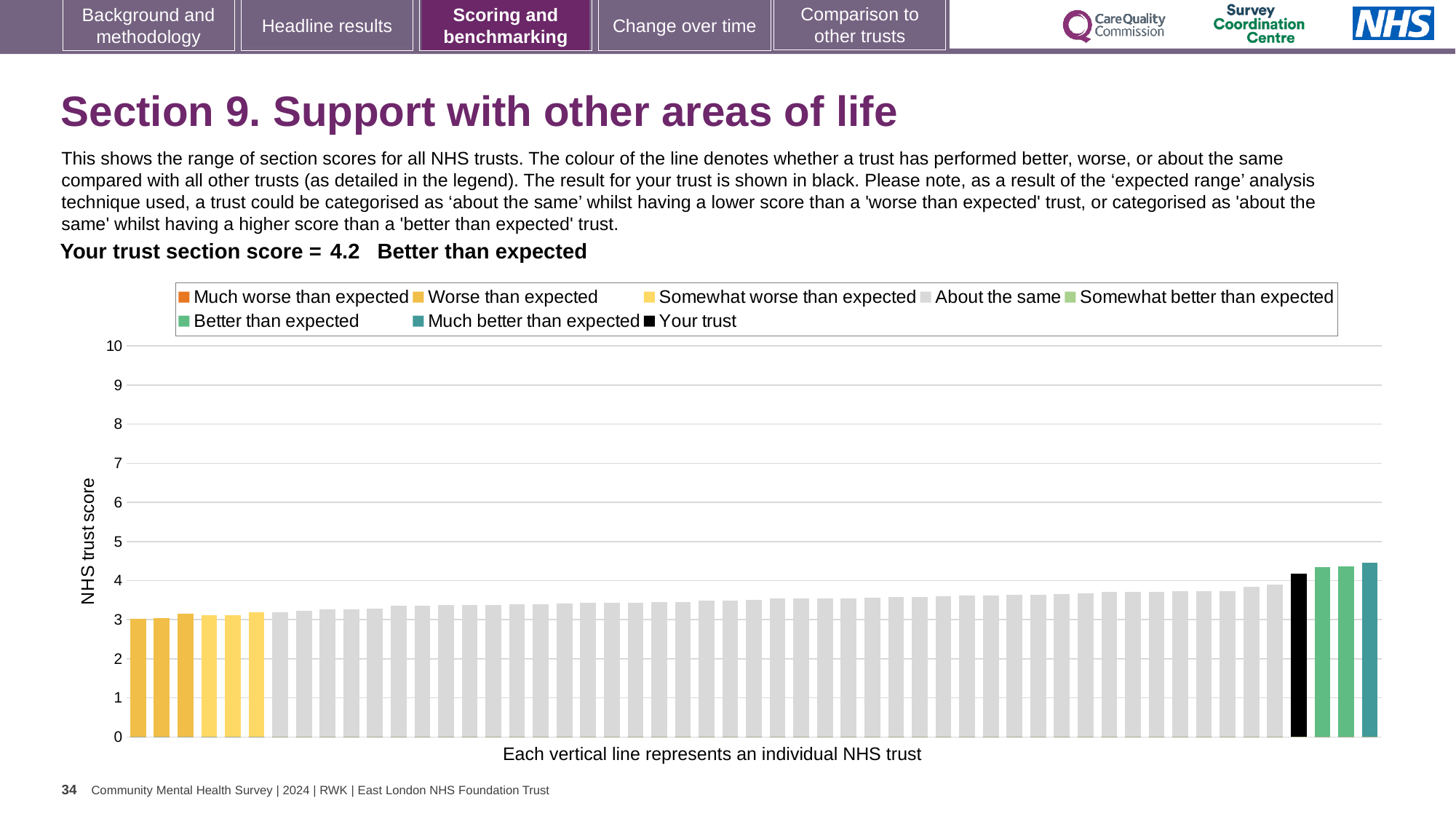
What is the section score for your trust shown on the slide? 4.2 Is your trust's score higher or lower than every 'About the same' trust? higher Is the value for the lowest-scoring trust greater or less than 4? less Which performance category is your trust placed in for this section? Better than expected Is the value for the highest-scoring trust greater or less than 5? less How many entries does the chart legend list? 8 What is the label on the vertical axis of the chart? NHS trust score Do the trust scores rise or fall moving from left to right along the x axis? rise What kind of chart is shown on the slide? bar chart Is the value for your trust greater or less than 4? greater Which legend category does the highest-scoring trust belong to? Much better than expected